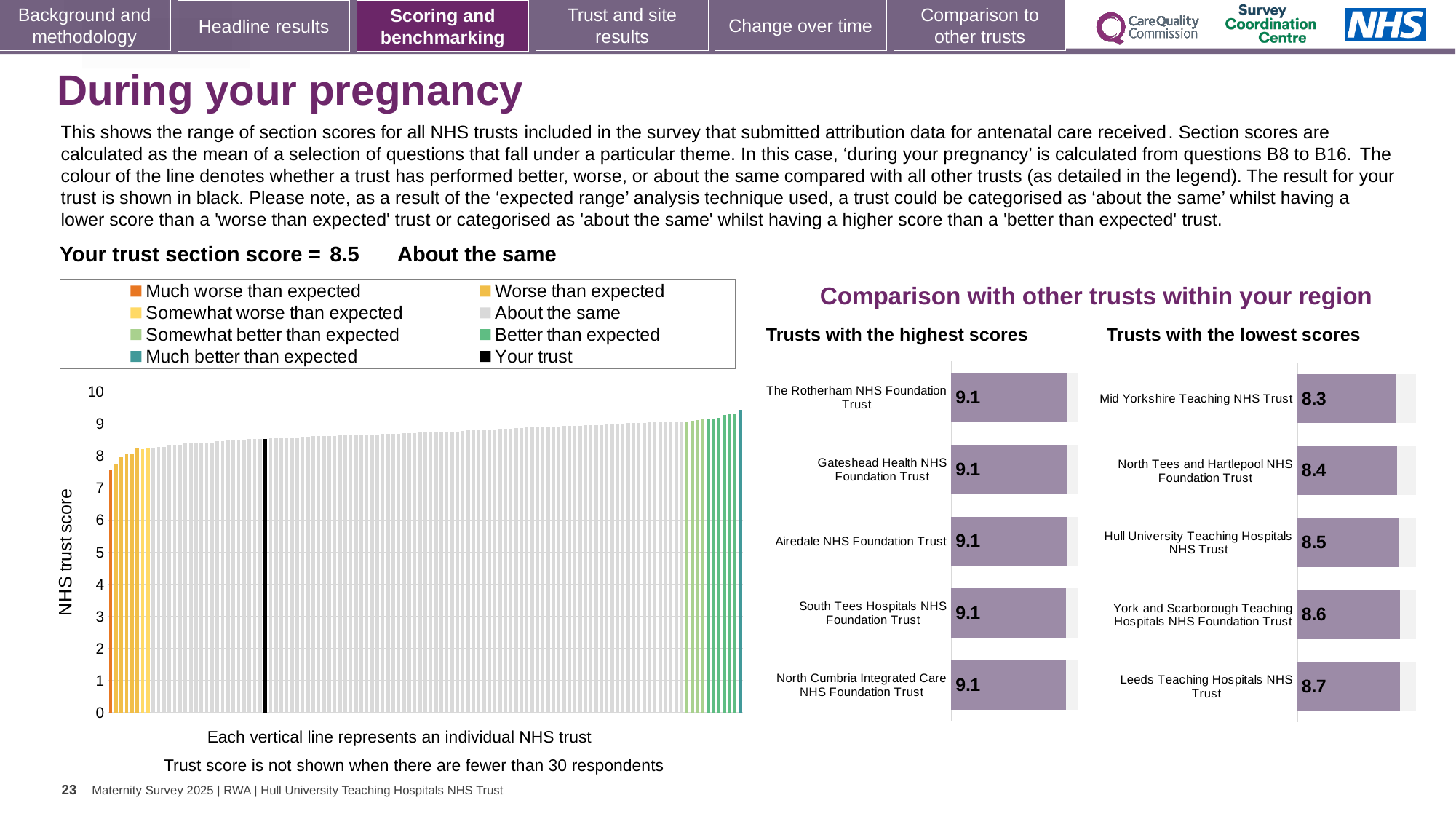
How many trusts are shown in the 'Trusts with the highest scores' chart? 5 In the 'Trusts with the lowest scores' chart, what is the difference between the scores of Leeds Teaching Hospitals NHS Trust and Mid Yorkshire Teaching NHS Trust? 0.4 How many entries does the legend of the NHS trust score chart on the left list? 8 In the 'Trusts with the highest scores' chart, what is the score for Airedale NHS Foundation Trust? 9.1 What kind of chart is the 'Trusts with the highest scores' chart? Bar chart In the 'Trusts with the lowest scores' chart, which trust has the highest score? Leeds Teaching Hospitals NHS Trust In the 'Trusts with the lowest scores' chart, what is the score for Mid Yorkshire Teaching NHS Trust? 8.3 In the NHS trust score chart on the left, do the values rise or fall from left to right? Rise In the 'Trusts with the lowest scores' chart, which trust has the lowest score? Mid Yorkshire Teaching NHS Trust In the NHS trust score chart on the left, is the value of the black 'Your trust' bar greater or less than 8? greater In the 'Trusts with the lowest scores' chart, which has the higher score: Hull University Teaching Hospitals NHS Trust or North Tees and Hartlepool NHS Foundation Trust? Hull University Teaching Hospitals NHS Trust In the 'Trusts with the lowest scores' chart, what is the score for Leeds Teaching Hospitals NHS Trust? 8.7